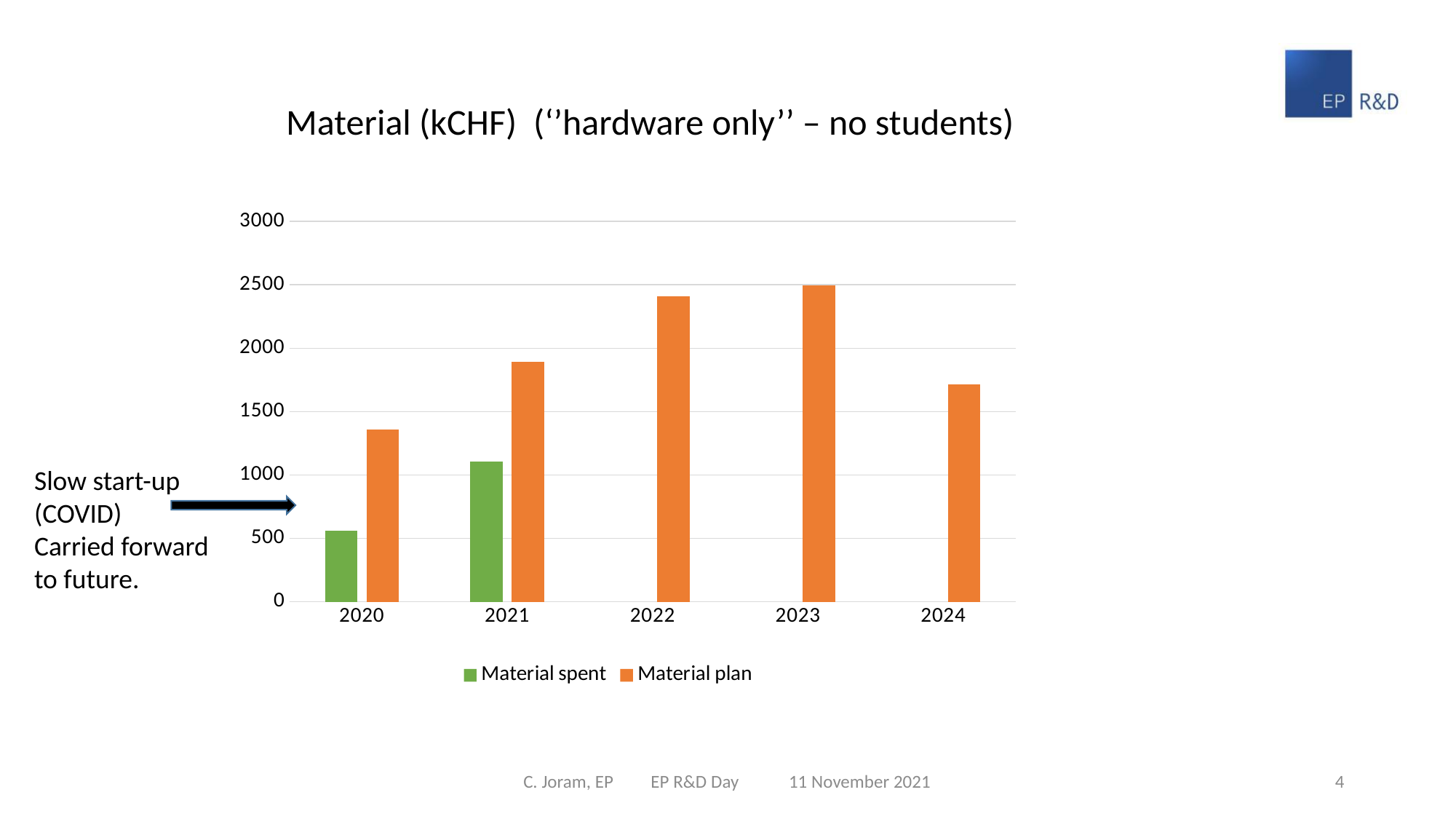
How many series does the legend list? 2 Is the Material plan value for 2024 greater or less than 1500? greater Does the Material plan value rise or fall from 2020 to 2023? rise Which year has the highest Material plan value? 2023 Is the Material spent value for 2021 greater or less than 1000? greater What kind of chart is shown on the slide? Bar chart Which is larger, Material spent in 2020 or Material spent in 2021? Material spent in 2021 How many years are shown on the x axis? 5 Is the Material plan value for 2020 greater or less than 1500? less Which year has the lowest Material plan value? 2020 Which colour represents the Material spent series? Green